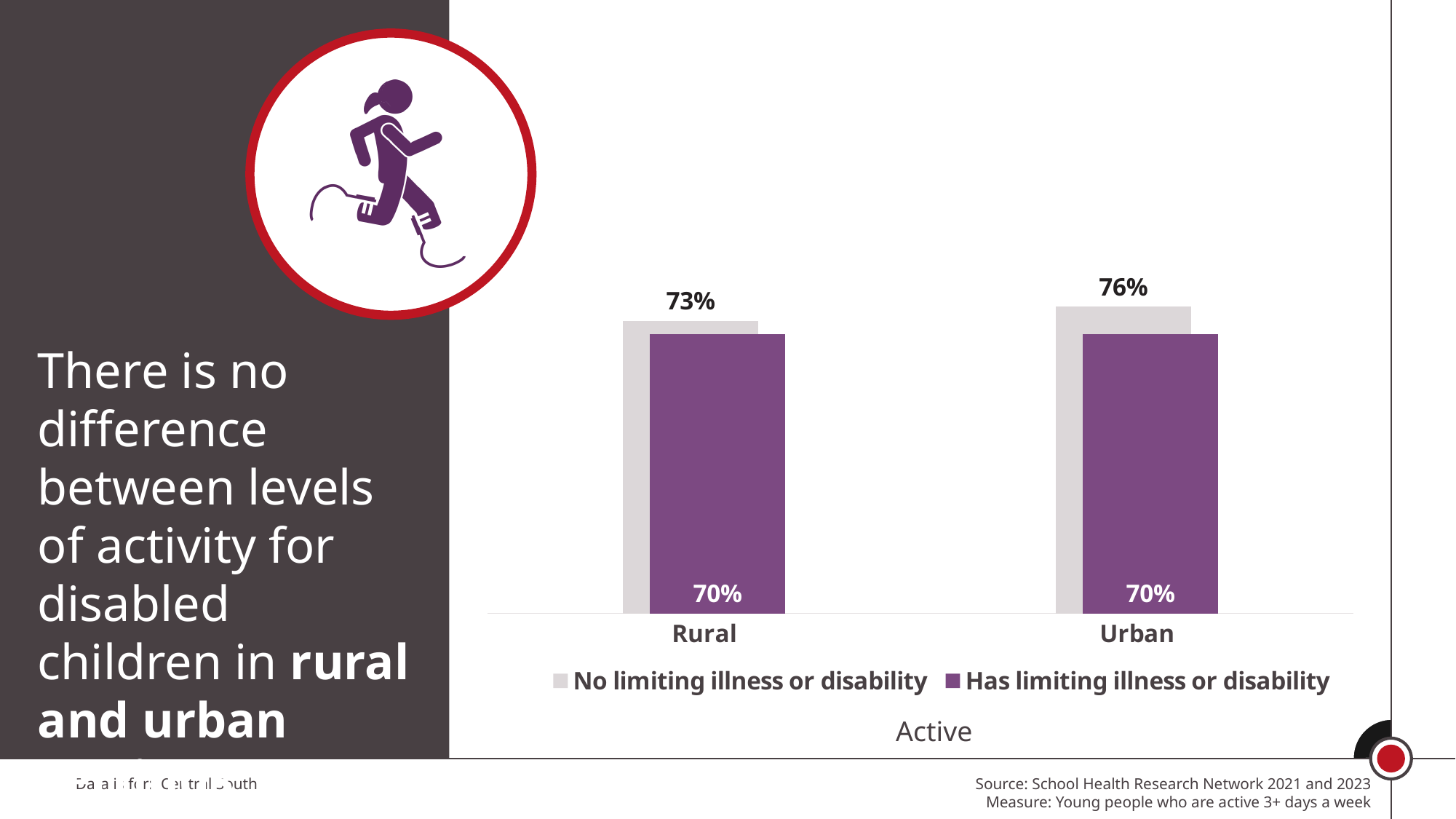
What is the value for 'Has limiting illness or disability' in the Urban category? 70% How many categories are shown on the x axis? 2 Which category has the higher value for 'No limiting illness or disability', Rural or Urban? Urban In the Urban category, what is the difference between 'No limiting illness or disability' and 'Has limiting illness or disability'? 6% In the Rural category, which series has the larger value, 'No limiting illness or disability' or 'Has limiting illness or disability'? No limiting illness or disability What is the value for 'No limiting illness or disability' in the Rural category? 73% What kind of chart is shown on the slide? Bar chart What is the value for 'Has limiting illness or disability' in the Rural category? 70% What is the difference between the 'No limiting illness or disability' values for Urban and Rural? 3% How many series does the legend list? 2 What is the title shown below the chart's legend? Active What is the value for 'No limiting illness or disability' in the Urban category? 76%